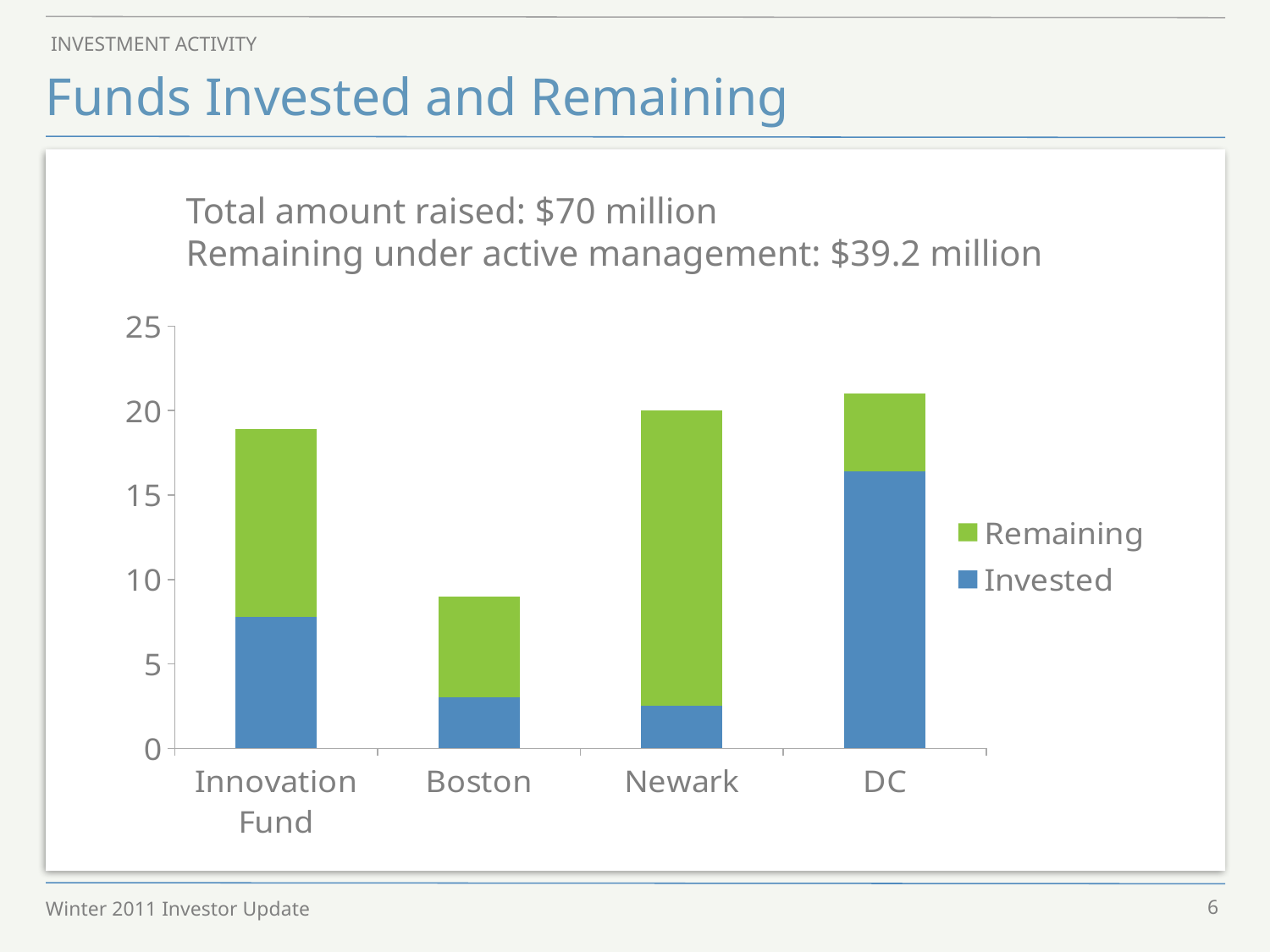
Is the total bar height larger for Newark or for Boston? Newark How many categories are shown on the x axis of the chart? 4 What are the two series named in the chart's legend? Remaining and Invested Which category has the lowest total bar height? Boston How many series does the chart's legend list? 2 Is the Invested value for Innovation Fund greater or less than 5? greater Is the total bar height for Innovation Fund greater or less than 20? less Is the Invested value for DC greater or less than 15? greater Which category has the largest Invested value? DC Is the Invested value larger for DC or for Innovation Fund? DC What kind of chart is shown on the slide? Stacked bar chart